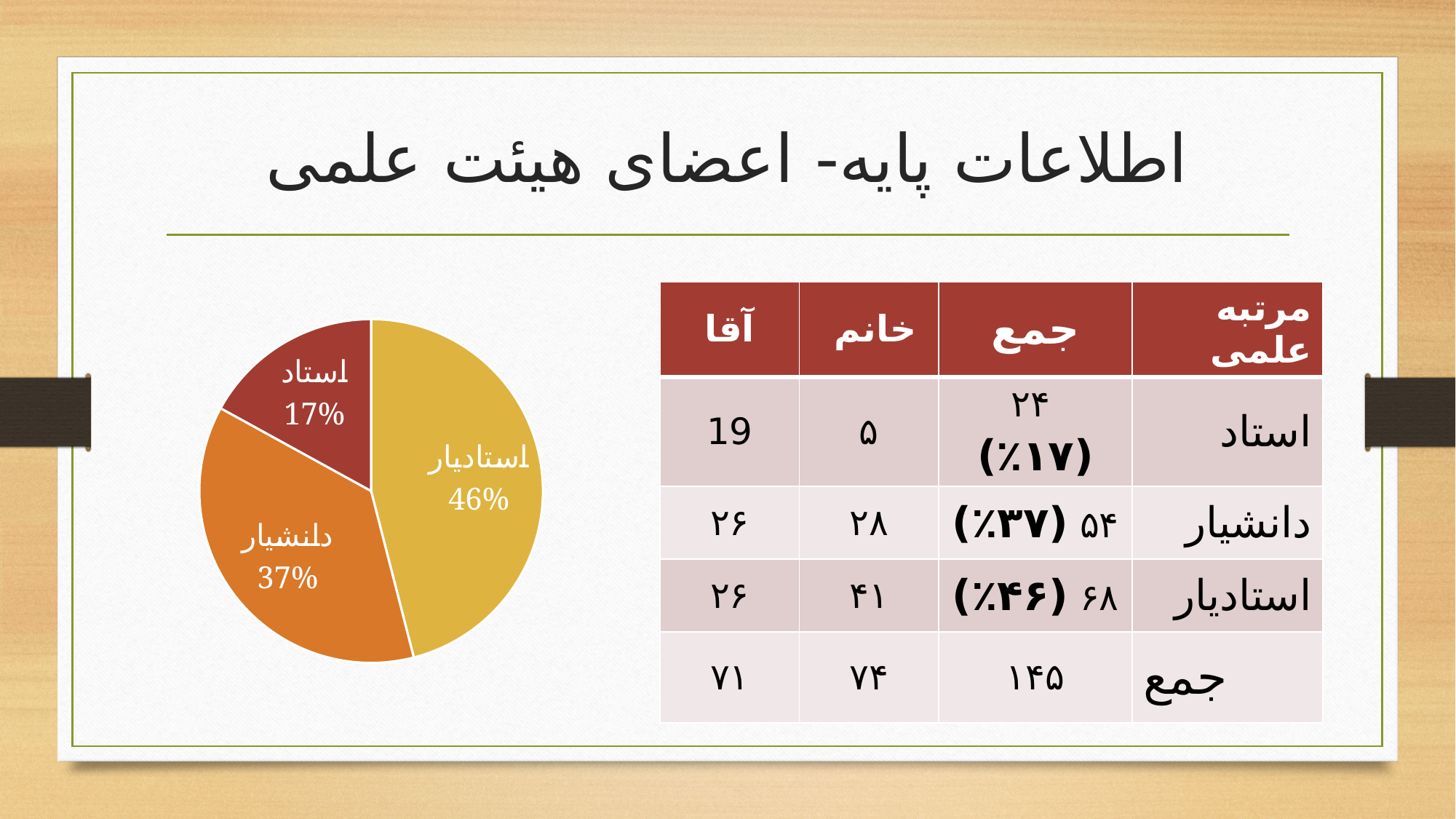
What is the difference in percentage points between the استادیار slice and the دانشیار slice? 9 What share of the pie does the استاد slice represent? 17% What colour is the استادیار slice in the pie chart? yellow What kind of chart is shown on the slide? pie chart What is the difference in percentage points between the استادیار slice and the استاد slice? 29 What share of the pie does the دانشیار slice represent? 37% Which slice of the pie chart is the smallest? استاد What colour is the استاد slice in the pie chart? dark red How many slices does the pie chart have? 3 Which slice of the pie chart is the largest? استادیار What share of the pie does the استادیار slice represent? 46% Which slice is larger in the pie chart, دانشیار or استاد? دانشیار